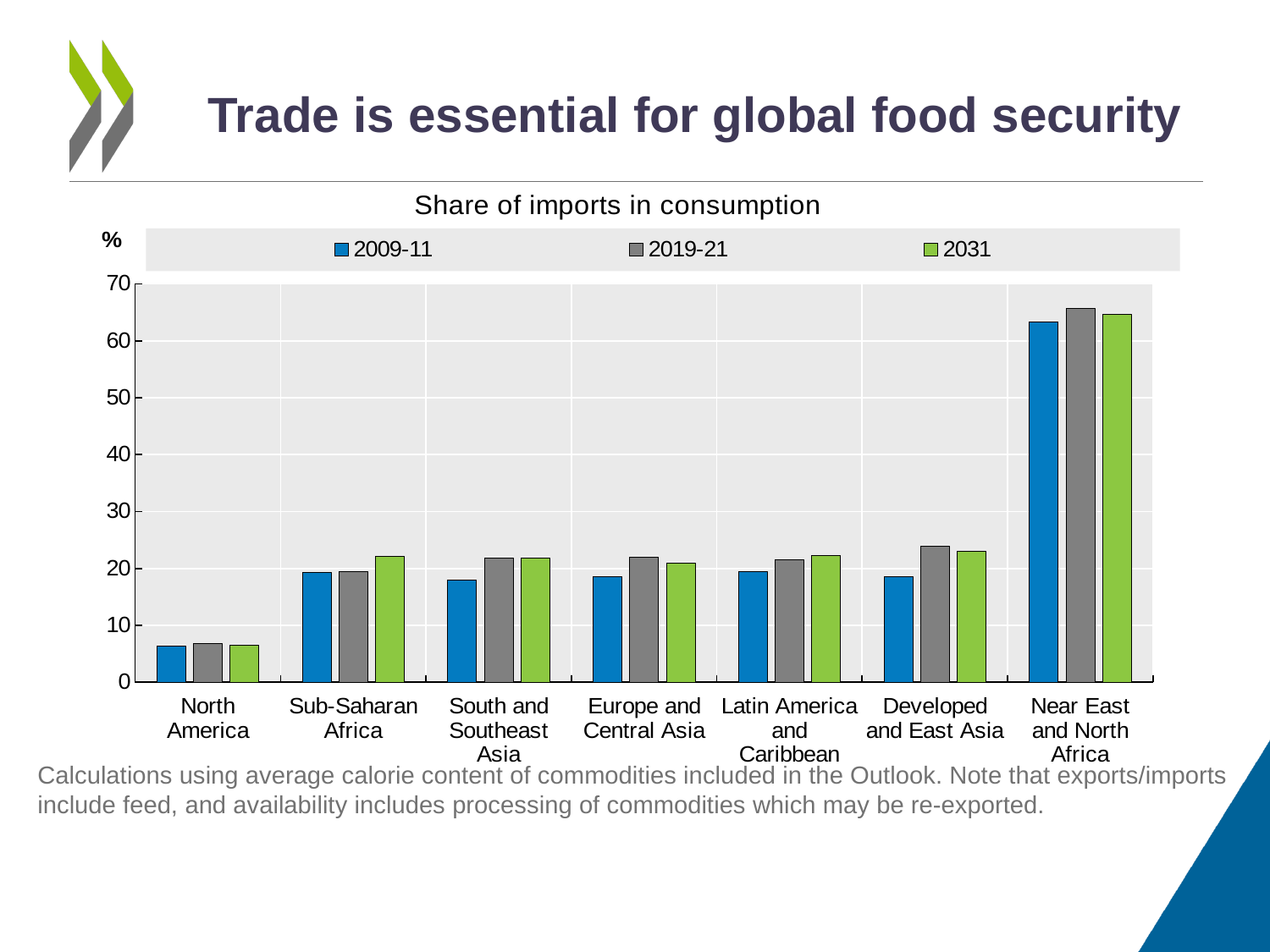
Is the 2019-21 value for Near East and North Africa greater or less than 60? greater For 2009-11, which region has the larger value: Near East and North Africa or Sub-Saharan Africa? Near East and North Africa Is the 2031 value for North America greater or less than 10? less For Developed and East Asia, which series has the larger value: 2009-11 or 2019-21? 2019-21 What kind of chart is shown on the slide? bar chart Which region has the lowest share of imports in consumption for 2009-11? North America Is the 2019-21 value for Developed and East Asia greater or less than 20? greater How many series does the legend list? 3 Which series is shown in green in the legend? 2031 Which region has the highest share of imports in consumption for 2031? Near East and North Africa How many regions are shown on the x axis? 7 What is the title of the chart? Share of imports in consumption